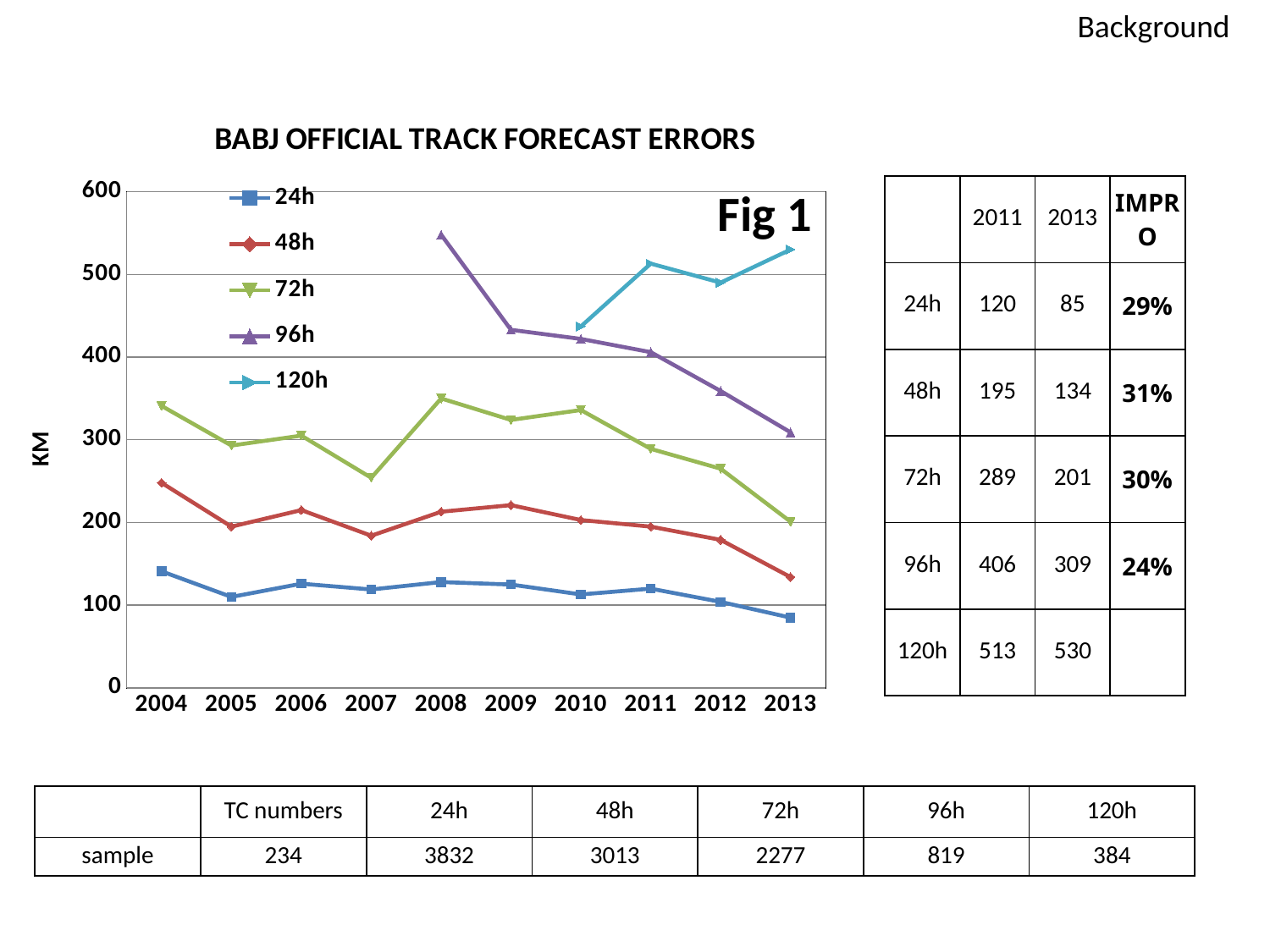
In the BABJ OFFICIAL TRACK FORECAST ERRORS chart, which series has the larger value in 2011, 96h or 120h? 120h In the BABJ OFFICIAL TRACK FORECAST ERRORS chart, is the 96h value for 2008 greater or less than 500? greater Using the table next to the BABJ OFFICIAL TRACK FORECAST ERRORS chart, by how much did the 24h value decrease from 2011 to 2013? 35 In the BABJ OFFICIAL TRACK FORECAST ERRORS chart, does the 24h series rise or fall overall from 2004 to 2013? fall In the BABJ OFFICIAL TRACK FORECAST ERRORS chart, is the 72h value for 2007 greater or less than 300? less How many series does the legend of the BABJ OFFICIAL TRACK FORECAST ERRORS chart list? 5 What is the label on the y axis of the BABJ OFFICIAL TRACK FORECAST ERRORS chart? KM How many years are shown on the x axis of the BABJ OFFICIAL TRACK FORECAST ERRORS chart? 10 In the BABJ OFFICIAL TRACK FORECAST ERRORS chart, is the 48h value for 2004 greater or less than 200? greater In the BABJ OFFICIAL TRACK FORECAST ERRORS chart, which year has the lowest 24h value? 2013 According to the table next to the BABJ OFFICIAL TRACK FORECAST ERRORS chart, what is the 48h value for 2013? 134 What kind of chart is Fig 1 (BABJ OFFICIAL TRACK FORECAST ERRORS)? line chart